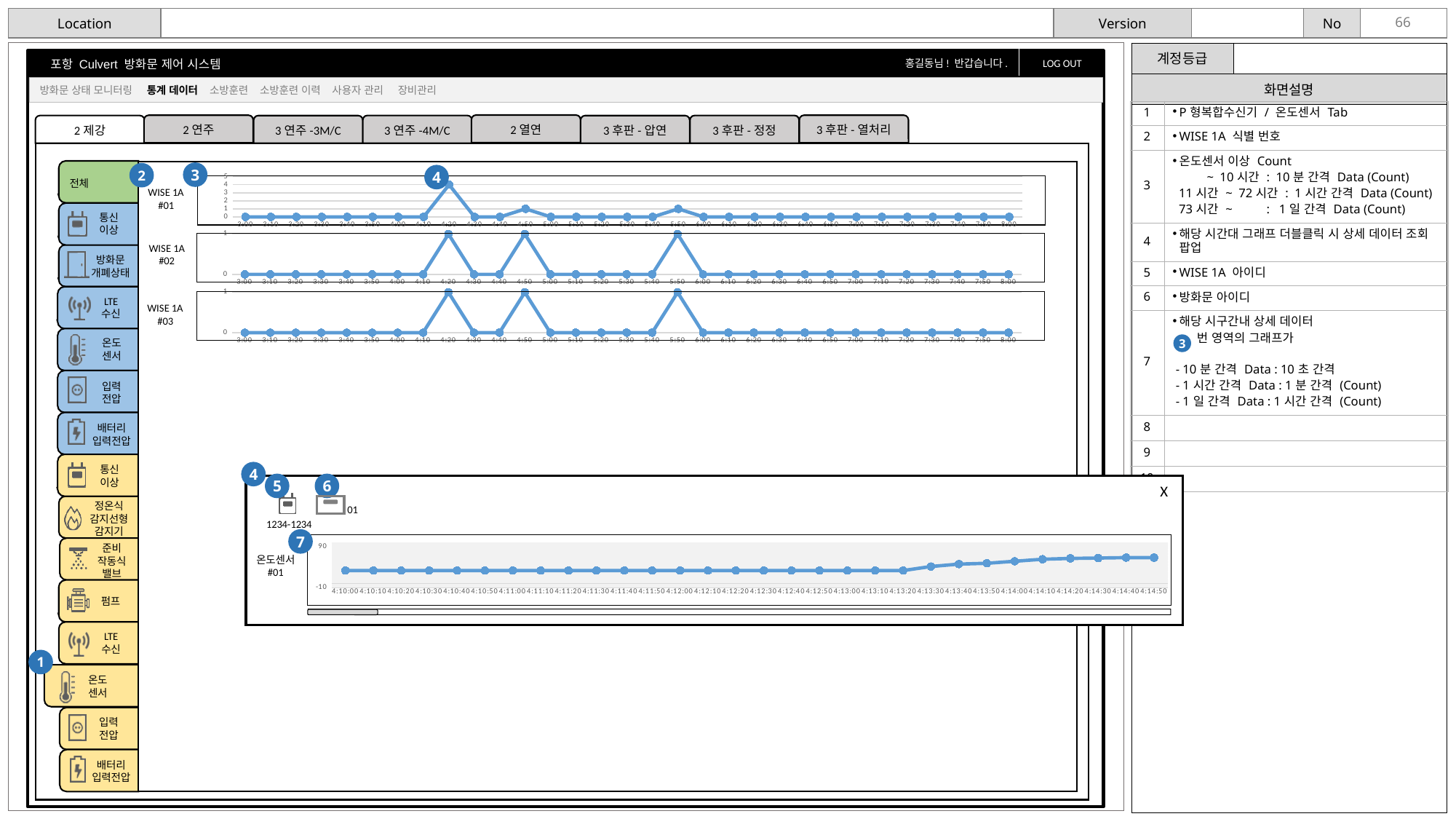
On the 온도센서 #01 chart in the popup, do the values rise or fall toward the right end of the x axis? rise On the WISE 1A #03 chart, what is the value at 5:50? 1 What is the highest value shown on the y axis of the 온도센서 #01 chart in the popup? 90 On the WISE 1A #02 chart, what is the value at 3:00? 0 On the 온도센서 #01 chart in the popup, is the value at 4:14:50 greater or less than 90? less On the WISE 1A #02 chart, what is the value at 4:20? 1 What are the first and last time labels on the x axis of the WISE 1A #01 chart? 3:00 and 8:00 What kind of chart is the WISE 1A #02 chart? line chart How many data points are plotted on the WISE 1A #02 chart? 31 On the WISE 1A #01 chart, is the value at 4:20 greater or less than 2? greater On the WISE 1A #01 chart, at which time is the value highest? 4:20 On the WISE 1A #02 chart, which is larger, the value at 4:20 or the value at 4:30? 4:20